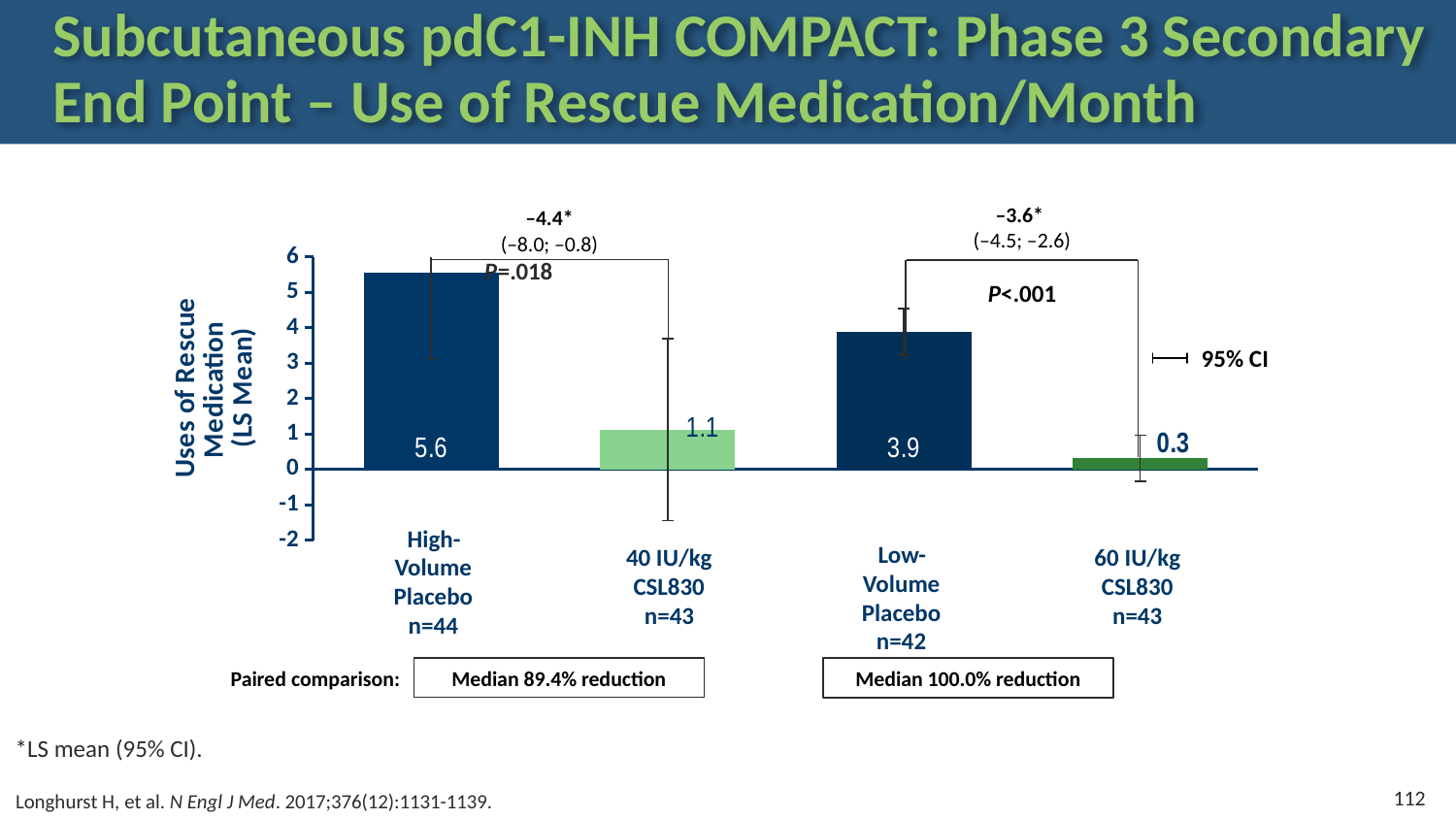
What is the difference in LS mean uses of rescue medication between the High-Volume Placebo and 40 IU/kg CSL830 groups? 4.4 Which group has the lowest LS mean uses of rescue medication? 60 IU/kg CSL830 What kind of chart is shown on the slide? Bar chart What is the LS mean uses of rescue medication for the 40 IU/kg CSL830 group? 1.1 Which group has the highest LS mean uses of rescue medication? High-Volume Placebo How many groups (bars) are shown in the chart? 4 What is the label of the y-axis of the chart? Uses of Rescue Medication (LS Mean) What is the LS mean uses of rescue medication for the Low-Volume Placebo group? 3.9 What is the LS mean uses of rescue medication for the High-Volume Placebo group? 5.6 What is the difference in LS mean uses of rescue medication between the Low-Volume Placebo and 60 IU/kg CSL830 groups? 3.6 Which has a higher LS mean uses of rescue medication, the 40 IU/kg CSL830 group or the 60 IU/kg CSL830 group? 40 IU/kg CSL830 What is the LS mean uses of rescue medication for the 60 IU/kg CSL830 group? 0.3